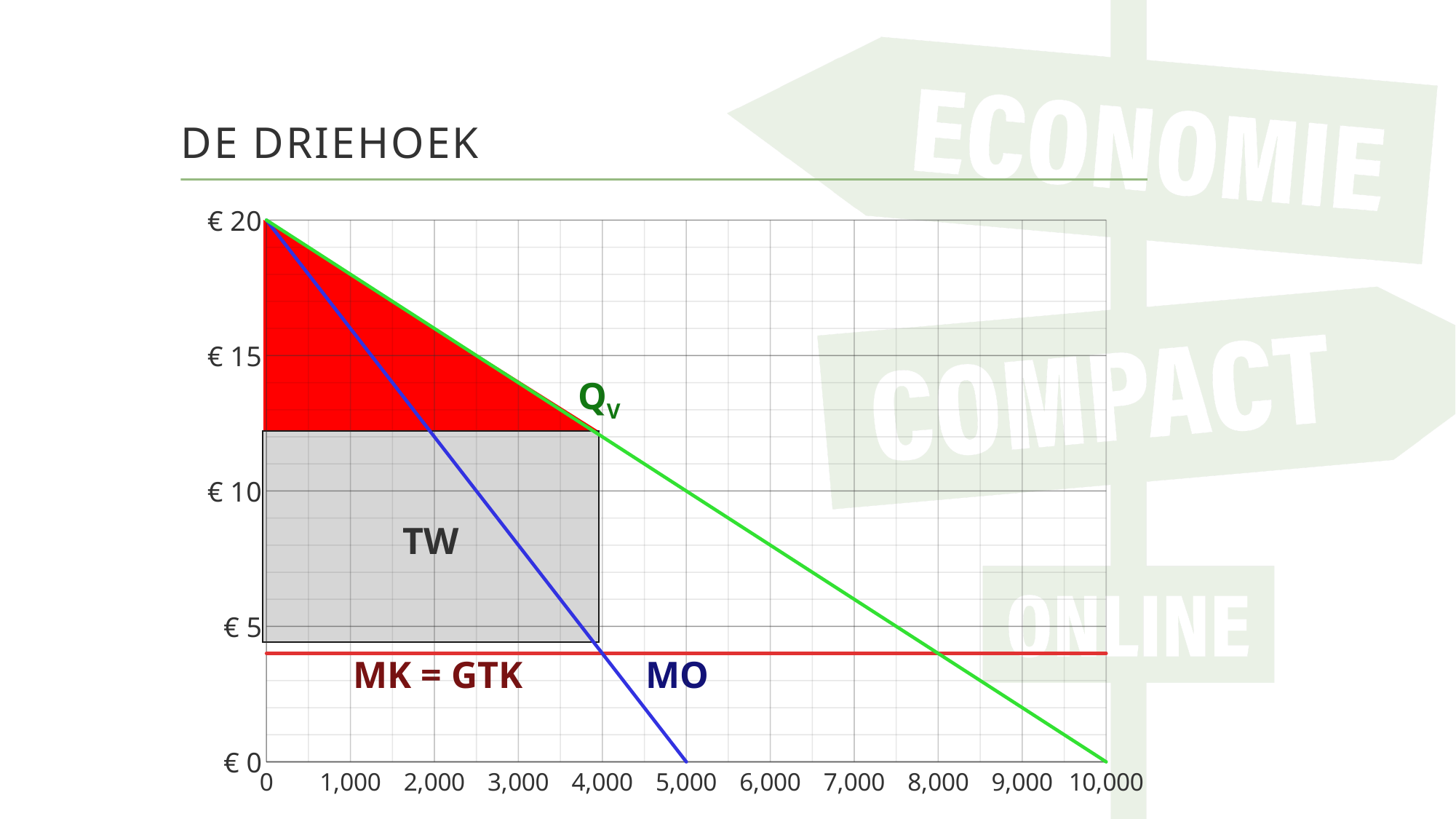
Is the value of the red MK = GTK line greater or less than € 5? less Does the green line rise or fall as quantity increases along the x axis? falls At what quantity is the point Qv located on the x axis? 4,000 At a quantity of 3,000, which line is higher: the green line or the blue MO line? the green line What is the title of the slide? DE DRIEHOEK What label is written inside the grey rectangle? TW What is the value of the green line at a quantity of 0? € 20 At what quantity does the blue MO line reach € 0? 5,000 What kind of chart is shown on the slide? line chart Is the value of the blue MO line at a quantity of 2,000 greater or less than € 10? greater Is the price at point Qv on the green line greater or less than € 10? greater At what quantity does the green line reach € 0? 10,000